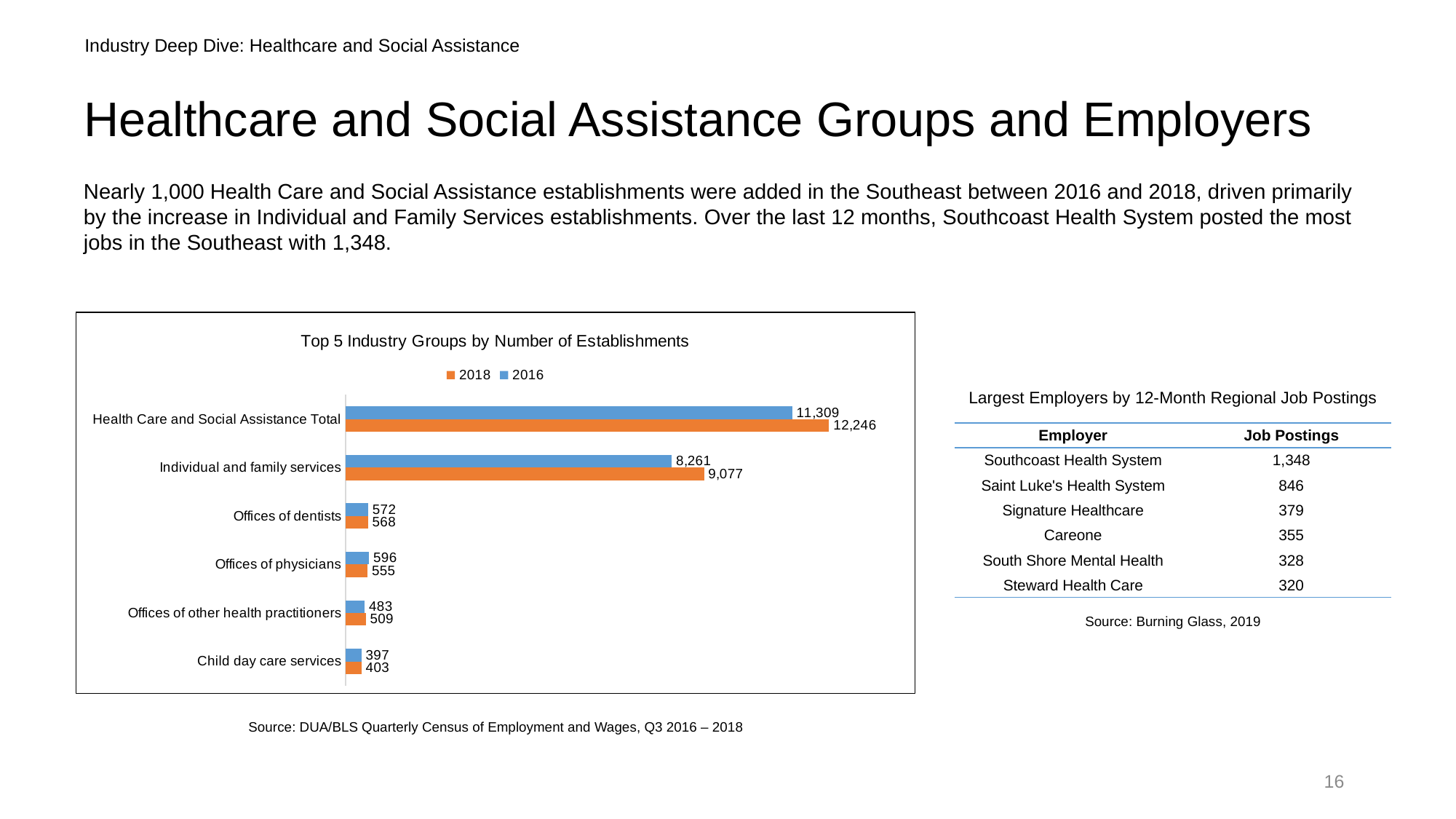
How many series does the legend of the 'Top 5 Industry Groups by Number of Establishments' chart list? 2 What type of chart is 'Top 5 Industry Groups by Number of Establishments'? bar chart In the 'Top 5 Industry Groups by Number of Establishments' chart, which category has the highest 2018 value? Health Care and Social Assistance Total What is the 2018 value for Child day care services in the 'Top 5 Industry Groups by Number of Establishments' chart? 403 In the 'Top 5 Industry Groups by Number of Establishments' chart, is the 2018 value for Offices of other health practitioners larger than its 2016 value? Yes What is the 2016 value for Offices of physicians in the 'Top 5 Industry Groups by Number of Establishments' chart? 596 In the 'Top 5 Industry Groups by Number of Establishments' chart, what is the difference between the 2018 and 2016 values for Health Care and Social Assistance Total? 937 Which colour represents the 2018 series in the 'Top 5 Industry Groups by Number of Establishments' chart? Orange In the 'Top 5 Industry Groups by Number of Establishments' chart, what is the difference between the 2016 and 2018 values for Offices of physicians? 41 How many categories are shown on the 'Top 5 Industry Groups by Number of Establishments' chart? 6 What is the 2018 value for Individual and family services in the 'Top 5 Industry Groups by Number of Establishments' chart? 9,077 In the 'Top 5 Industry Groups by Number of Establishments' chart, which category has the lowest 2016 value? Child day care services